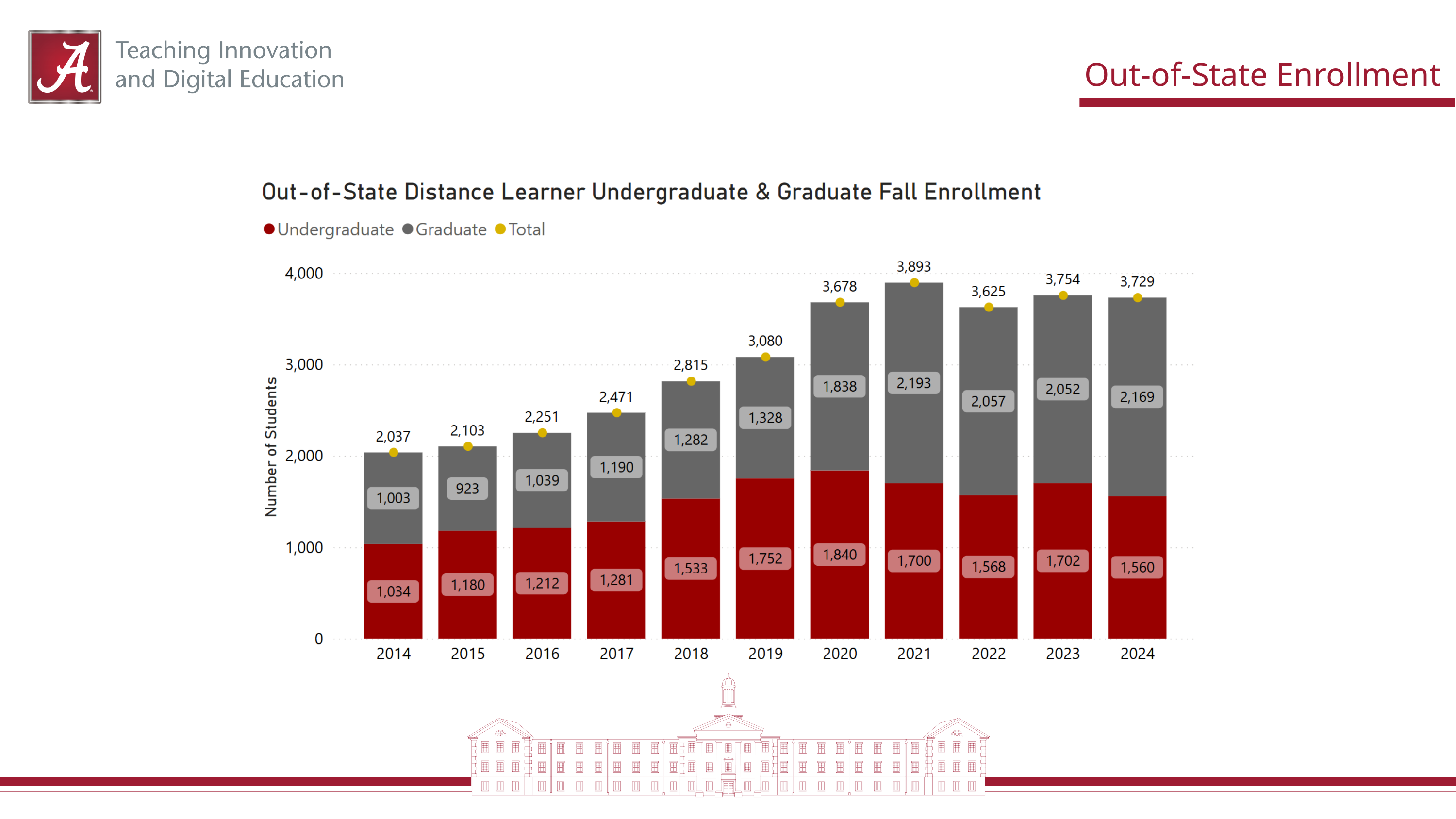
How many series does the legend list? 3 What is the Graduate enrollment for 2016? 1,039 What is the difference between the Graduate and Undergraduate enrollment in 2024? 609 Which is larger in 2019, the Undergraduate or the Graduate enrollment? Undergraduate What is the Undergraduate enrollment for 2020? 1,840 Which year has the lowest Graduate enrollment? 2015 What is the title of the chart? Out-of-State Distance Learner Undergraduate & Graduate Fall Enrollment Which year has the highest Total enrollment? 2021 What kind of chart is shown on the slide? Stacked bar chart Is the Total enrollment for 2018 greater or less than 3,000? less What is the Total enrollment for 2021? 3,893 How many years are shown on the x axis? 11